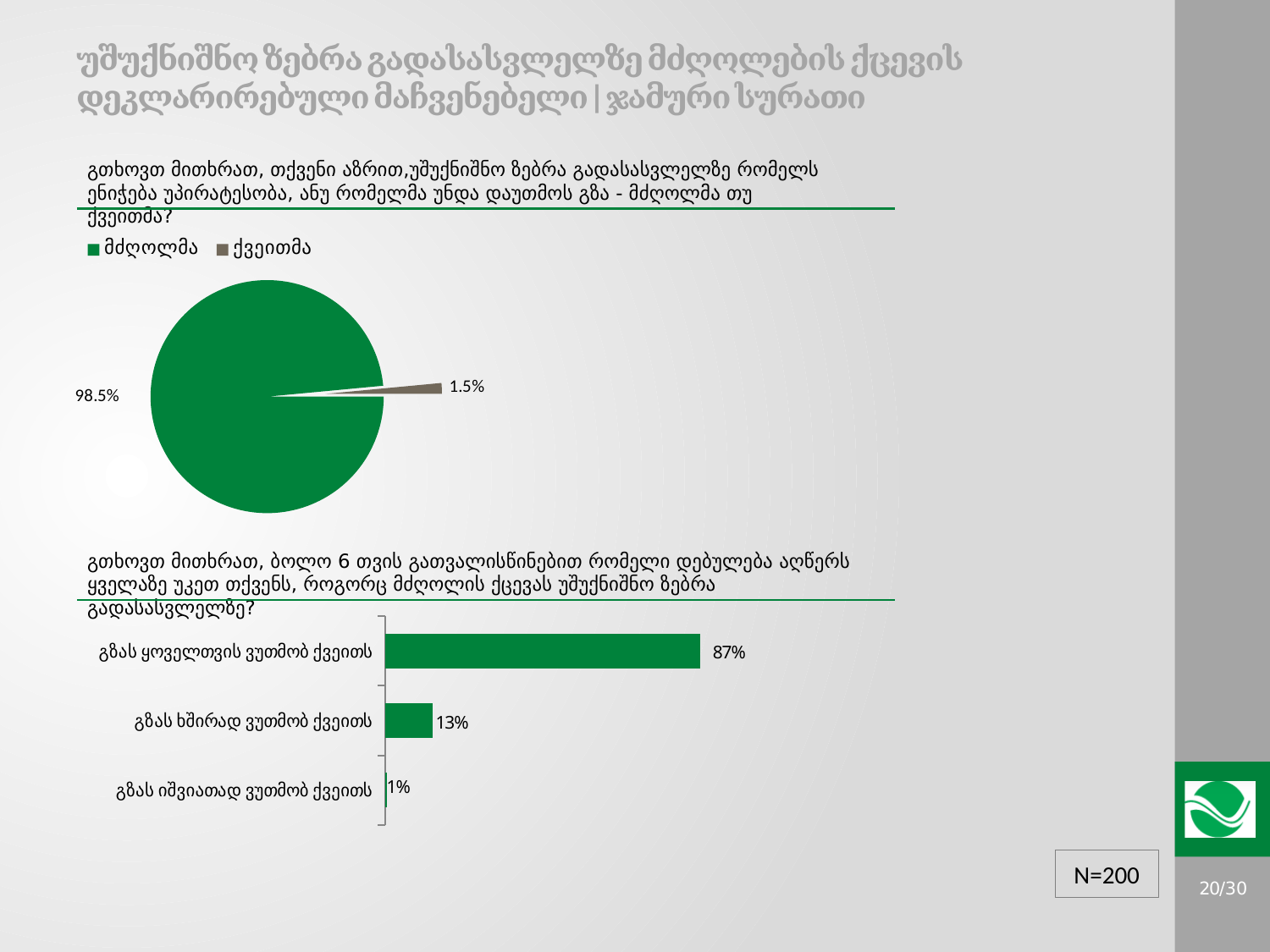
In the pie chart at the top of the slide, how many entries does the legend list? 2 In the pie chart at the top of the slide, what share is shown for ქვეითმა? 1.5% In the bar chart at the bottom of the slide, which category has the lowest value? გზას იშვიათად ვუთმობ ქვეითს In the bar chart at the bottom of the slide, what is the value for გზას იშვიათად ვუთმობ ქვეითს? 1% In the pie chart at the top of the slide, which slice is the largest? მძღოლმა What kind of chart is the bottom chart on the slide? bar chart In the bar chart at the bottom of the slide, what is the value for გზას ხშირად ვუთმობ ქვეითს? 13% In the bar chart at the bottom of the slide, what is the value for გზას ყოველთვის ვუთმობ ქვეითს? 87% What kind of chart is the top chart on the slide? pie chart In the pie chart at the top of the slide, what share is shown for მძღოლმა? 98.5% In the pie chart at the top of the slide, how many slices are there? 2 In the bar chart at the bottom of the slide, what is the difference between the values for გზას ყოველთვის ვუთმობ ქვეითს and გზას ხშირად ვუთმობ ქვეითს? 74%